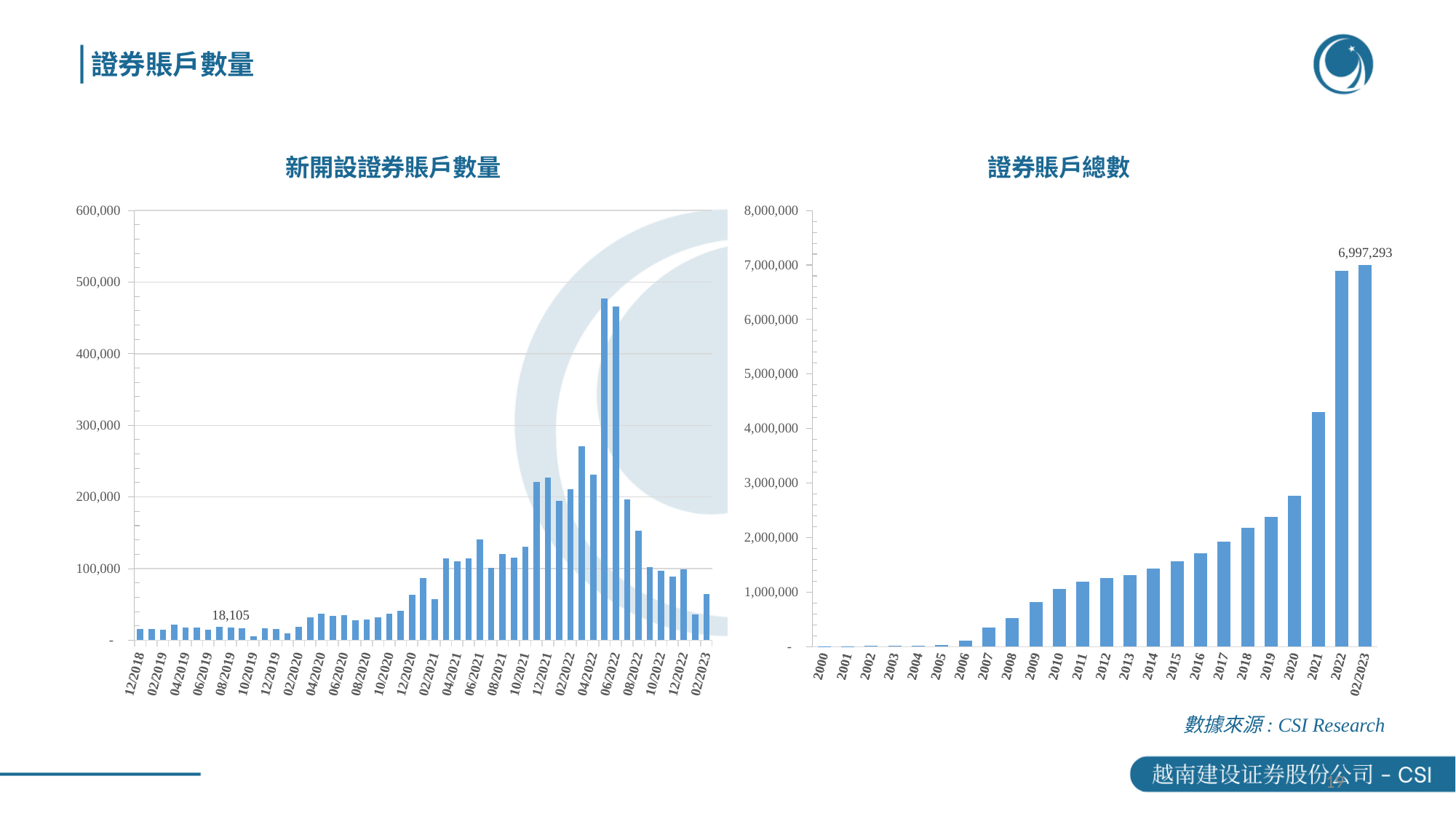
On the chart titled 證券賬戶總數, what is the value printed for 02/2023? 6,997,293 What data source is cited on the slide? CSI Research On the chart titled 證券賬戶總數, is the value for 2021 greater or less than 4,000,000? greater On the chart titled 證券賬戶總數, do the values generally rise or fall from 2000 to 02/2023? rise On the chart titled 新開設證券賬戶數量, is the value for 02/2023 greater or less than 100,000? less On the chart titled 證券賬戶總數, which is larger, the value for 2021 or the value for 2022? 2022 On the chart titled 證券賬戶總數, which category has the highest value? 02/2023 What kind of chart is the chart titled 新開設證券賬戶數量? bar chart On the chart titled 證券賬戶總數, how many bars are plotted? 24 On the chart titled 證券賬戶總數, is the value for 2020 greater or less than 3,000,000? less On the chart titled 新開設證券賬戶數量, what value is printed as a data label near the 2019 bars? 18,105